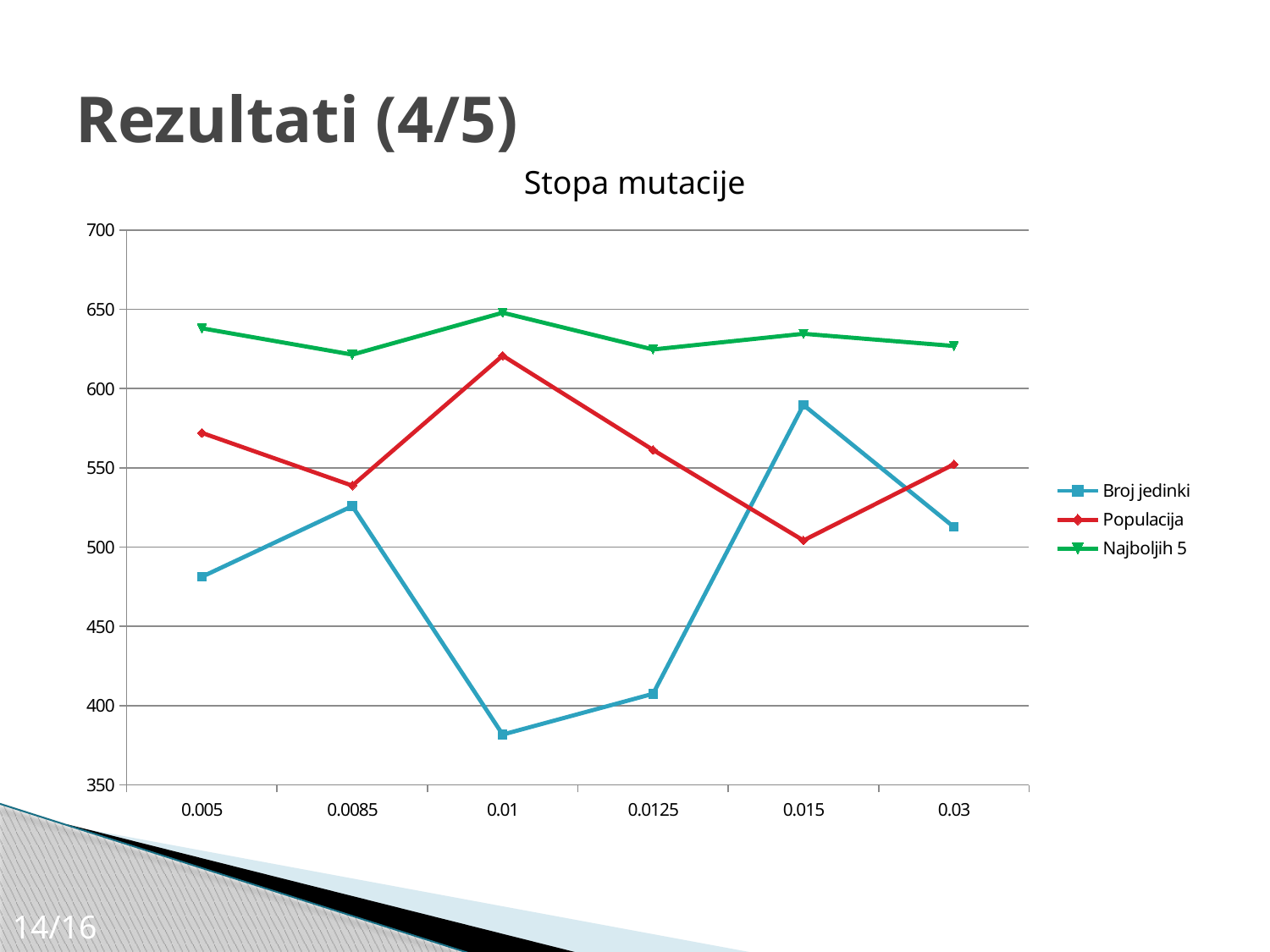
At which mutation rate does the Populacija series reach its lowest value? 0.015 At a mutation rate of 0.015, which is larger: Broj jedinki or Populacija? Broj jedinki At which mutation rate does the Broj jedinki series reach its highest value? 0.015 Does the Broj jedinki series rise or fall from 0.0085 to 0.01? fall How many series does the legend list? 3 Is the value for Broj jedinki at 0.01 greater or less than 400? less What kind of chart is shown on the slide? line chart How many mutation-rate values are shown on the x axis? 6 Is the value for Populacija at 0.01 greater or less than 600? greater At which mutation rate does the Broj jedinki series reach its lowest value? 0.01 At which mutation rate does the Populacija series reach its highest value? 0.01 What is the title of the chart? Stopa mutacije